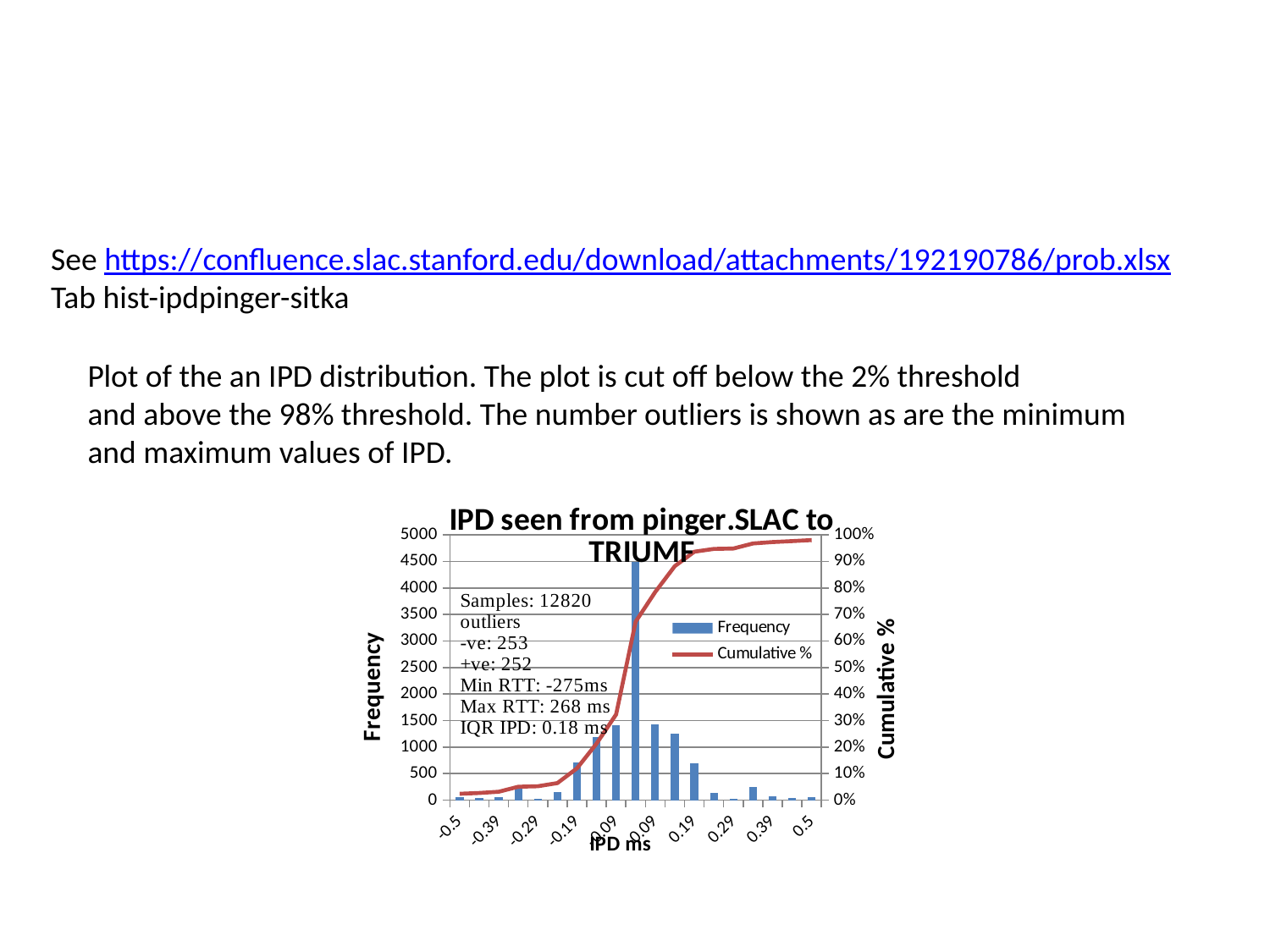
What IQR IPD value is stated in the chart annotation? 0.18 ms According to the chart annotation, how many negative (-ve) outliers are there? 253 What is the title of the chart? IPD seen from pinger.SLAC to TRIUMF Does the Cumulative % line rise or fall as IPD increases along the x axis? rises How many samples does the chart annotation report? 12820 How many series does the chart legend list? 2 Is the frequency of the tallest bar greater or less than 4000? greater Is the frequency value for the bar at 0.39 greater or less than 500? less What are the two series named in the chart legend? Frequency and Cumulative % Is the frequency value for the bar at -0.19 greater or less than 1000? less What kind of chart is shown on the slide? A combined bar and line chart What Max RTT is stated in the chart annotation? 268 ms